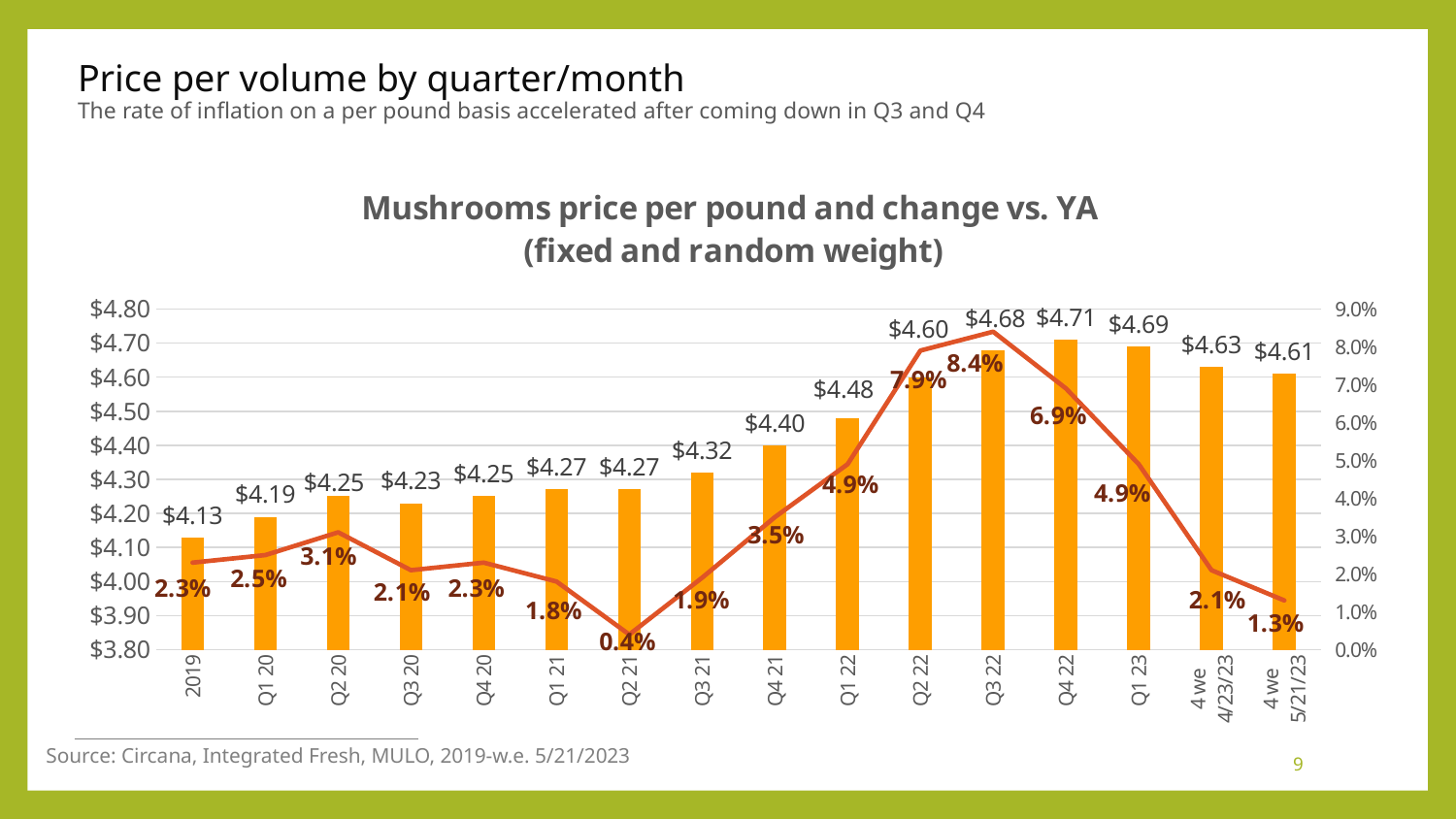
Which period has the lowest price per pound? 2019 Which has the higher price per pound, Q4 22 or Q1 23? Q4 22 What is the change vs. YA shown for the 4 we 5/21/23 period? 1.3% Which period has the lowest change vs. YA? Q2 21 What is the mushrooms price per pound for Q3 22? $4.68 Which period has the highest price per pound? Q4 22 Does the price per pound rise or fall from 2019 to Q4 22? Rise Which period has the highest change vs. YA? Q3 22 What is the difference between the price per pound in Q4 22 and in 2019? $0.58 How many periods are shown on the x axis? 16 What kind of chart is this? Combination bar and line chart What is the change vs. YA shown for Q2 21? 0.4%